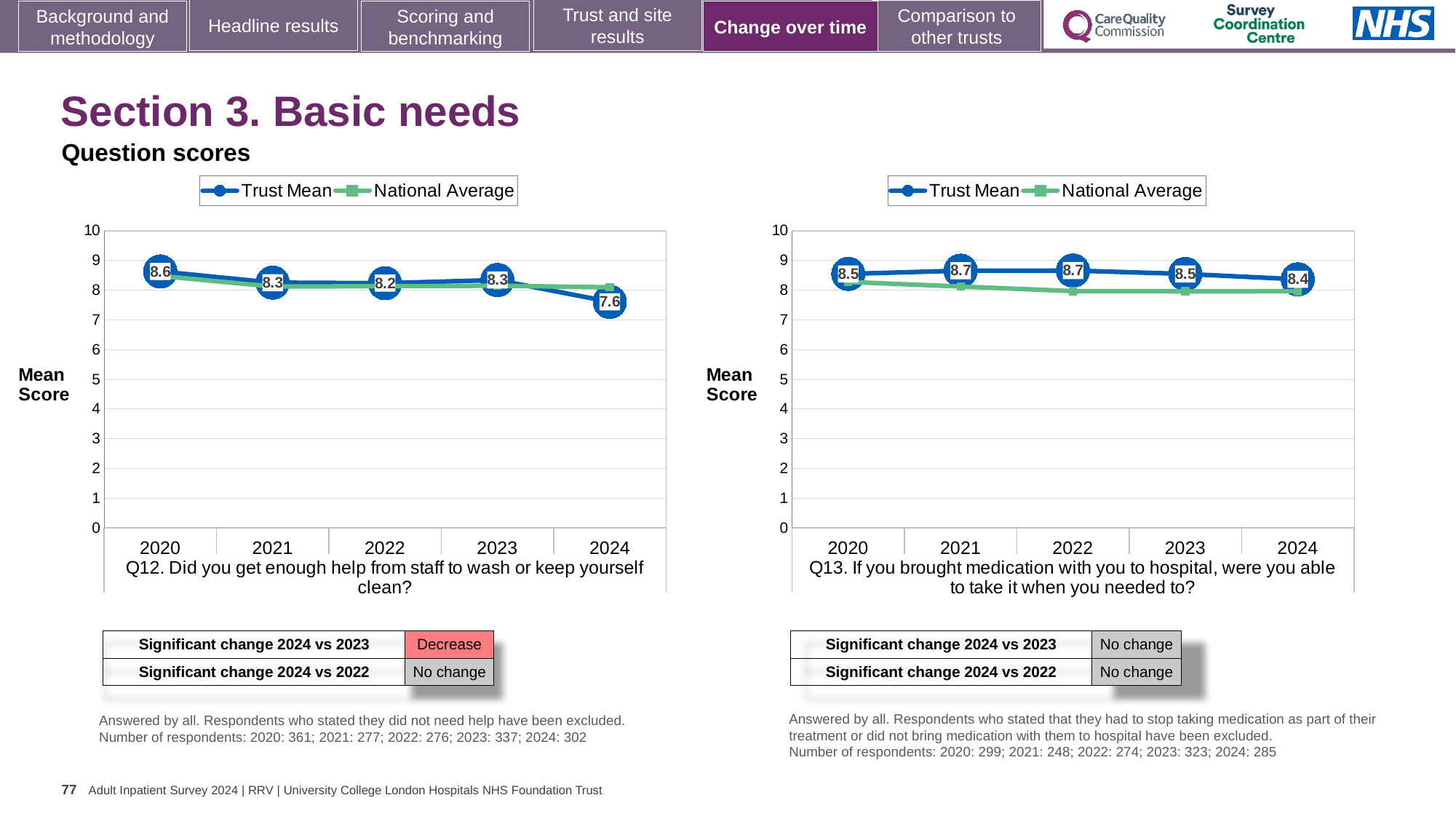
On the Q12 chart (left), which year has the lowest Trust Mean? 2024 How many series does the legend of the Q13 chart (right) list? 2 On the Q13 chart (right), is the National Average for 2024 greater or less than 9? less On the Q13 chart (right), is the Trust Mean for 2022 higher or lower than the Trust Mean for 2024? higher On the Q13 chart (right), what is the Trust Mean for 2021? 8.7 How many years are plotted on the Q12 chart (left)? 5 What type of chart is the Q12 chart (left)? Line chart On the Q12 chart (left), what is the Trust Mean for 2024? 7.6 On the Q12 chart (left), what is the difference between the Trust Mean in 2023 and in 2024? 0.7 On the Q12 chart (left), what is the Trust Mean for 2020? 8.6 On the Q12 chart (left), which year has the highest Trust Mean? 2020 On the Q13 chart (right), what is the Trust Mean for 2024? 8.4